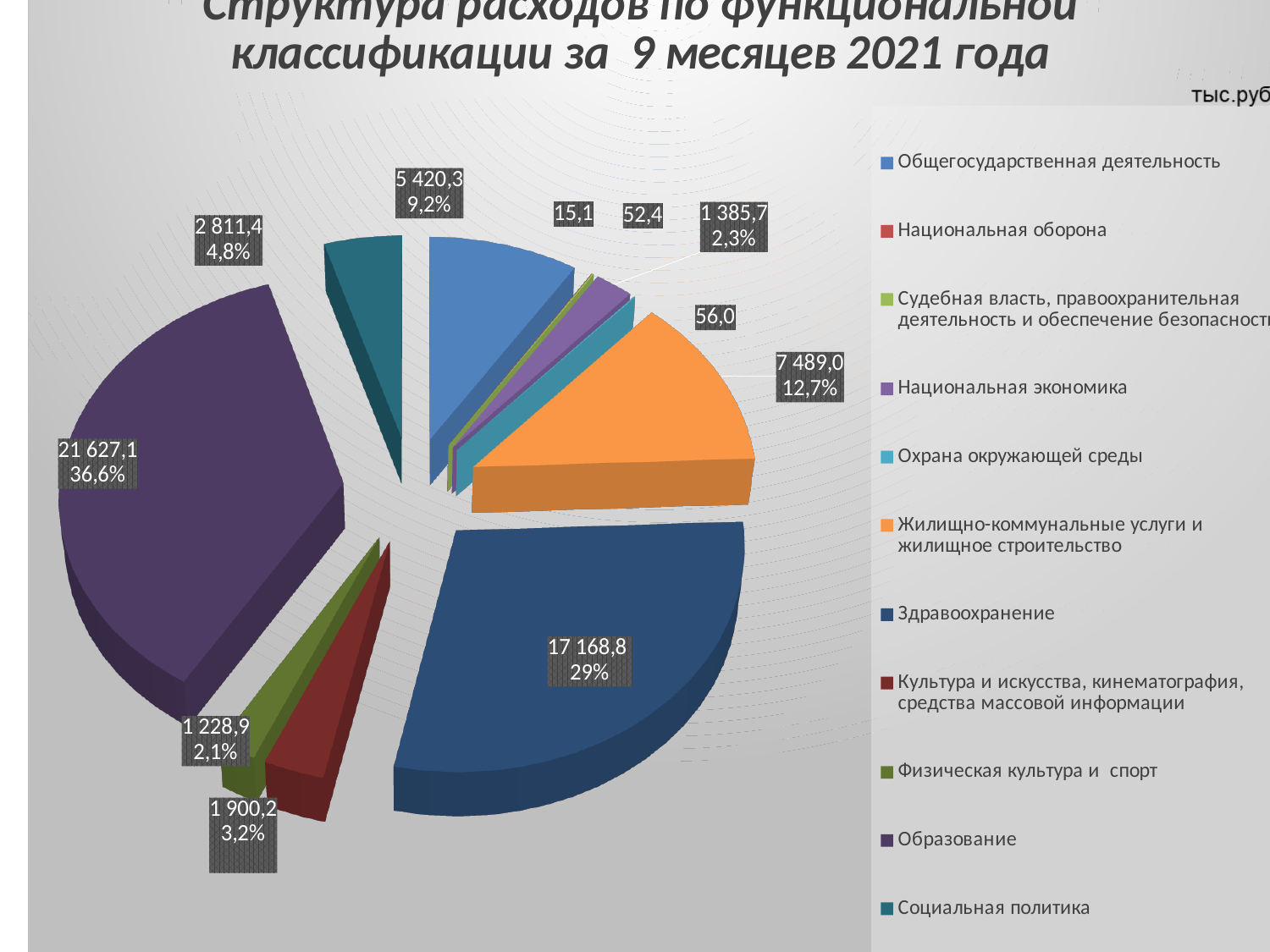
How many categories does the legend list? 11 What share of the pie does Образование account for? 36,6% What share of the pie does Общегосударственная деятельность account for? 9,2% What is the value for Жилищно-коммунальные услуги и жилищное строительство? 7 489,0 What is the difference between the values for Образование and Здравоохранение? 4 458,3 What kind of chart is shown on the slide? Pie chart Which category has the largest share of expenditures in the pie chart? Образование What is the value for Здравоохранение? 17 168,8 Which is larger, Образование or Здравоохранение? Образование In what units are the values on the chart given? тыс.руб What is the value for Социальная политика? 2 811,4 What share of the pie does Здравоохранение account for? 29%